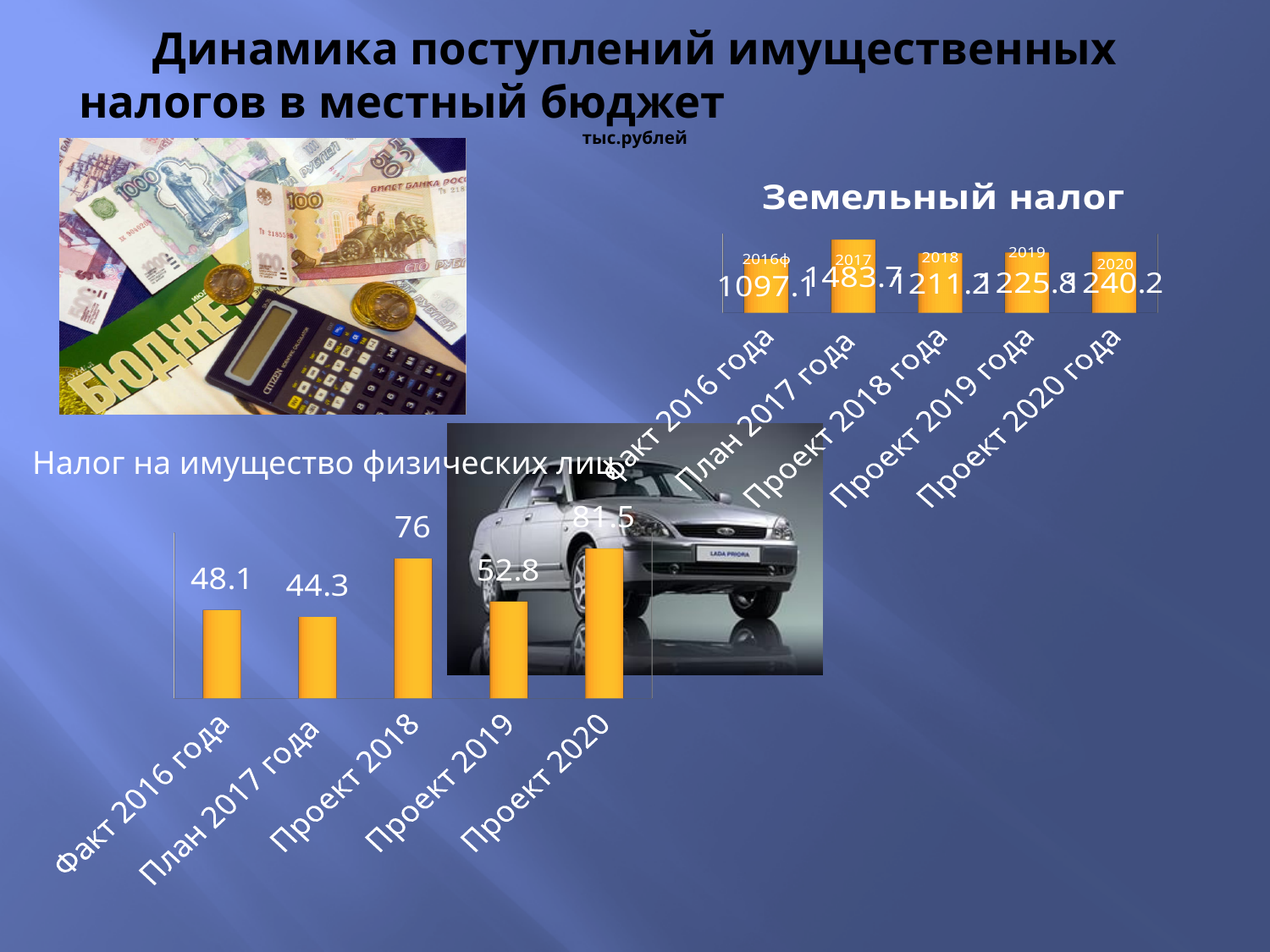
On the 'Налог на имущество физических лиц' chart, which category has the highest value? Проект 2020 On the 'Налог на имущество физических лиц' chart, what is the difference between Проект 2020 and Проект 2019? 28.7 On the 'Налог на имущество физических лиц' chart, what is the value for Факт 2016 года? 48.1 On the 'Земельный налог' chart, which category has the highest value? План 2017 года On the 'Налог на имущество физических лиц' chart, which is larger: Факт 2016 года or План 2017 года? Факт 2016 года On the 'Земельный налог' chart, what is the value for Факт 2016 года? 1097.1 What type of chart is the 'Земельный налог' chart? bar chart On the 'Земельный налог' chart, what is the value for План 2017 года? 1483.7 How many categories are shown on the 'Налог на имущество физических лиц' chart? 5 What unit is stated under the slide title for the charts? тыс.рублей On the 'Налог на имущество физических лиц' chart, what is the value for Проект 2018? 76 On the 'Налог на имущество физических лиц' chart, which category has the lowest value? План 2017 года